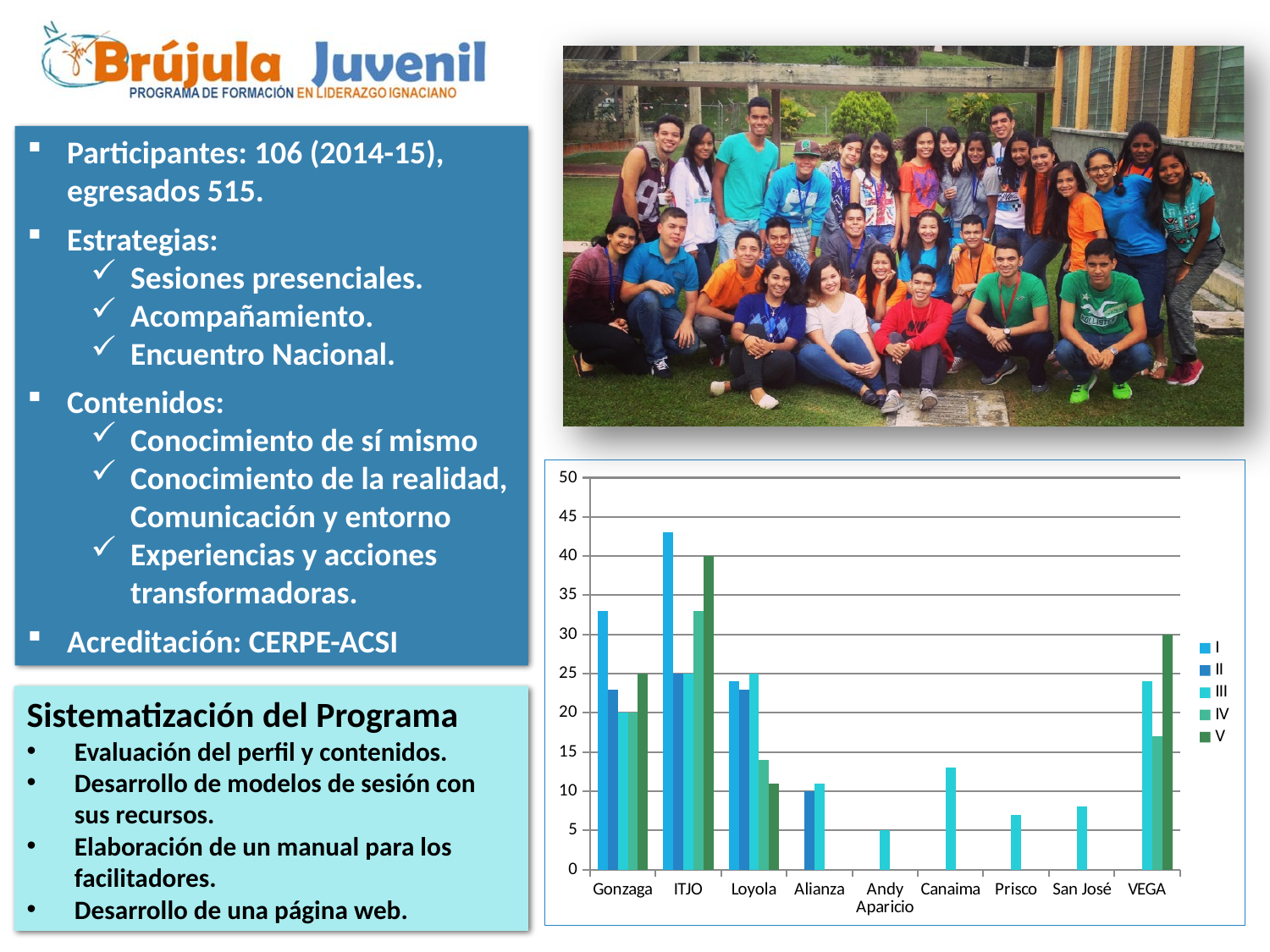
What kind of chart is shown on the slide? bar chart Is the value for series III at Andy Aparicio greater or less than 10? less How many categories are shown along the x axis of the chart? 9 Is the value for series III at Canaima greater or less than 10? greater Which category has the tallest bar for series I? ITJO Is the value for series V at VEGA greater or less than 25? greater How many series does the chart legend list? 5 What are the entries listed in the chart legend? I, II, III, IV, V Which category has the tallest bar for series V? ITJO At ITJO, which is larger, the series IV value or the series V value? series V Which is larger, the series I value for Gonzaga or the series I value for Loyola? Gonzaga